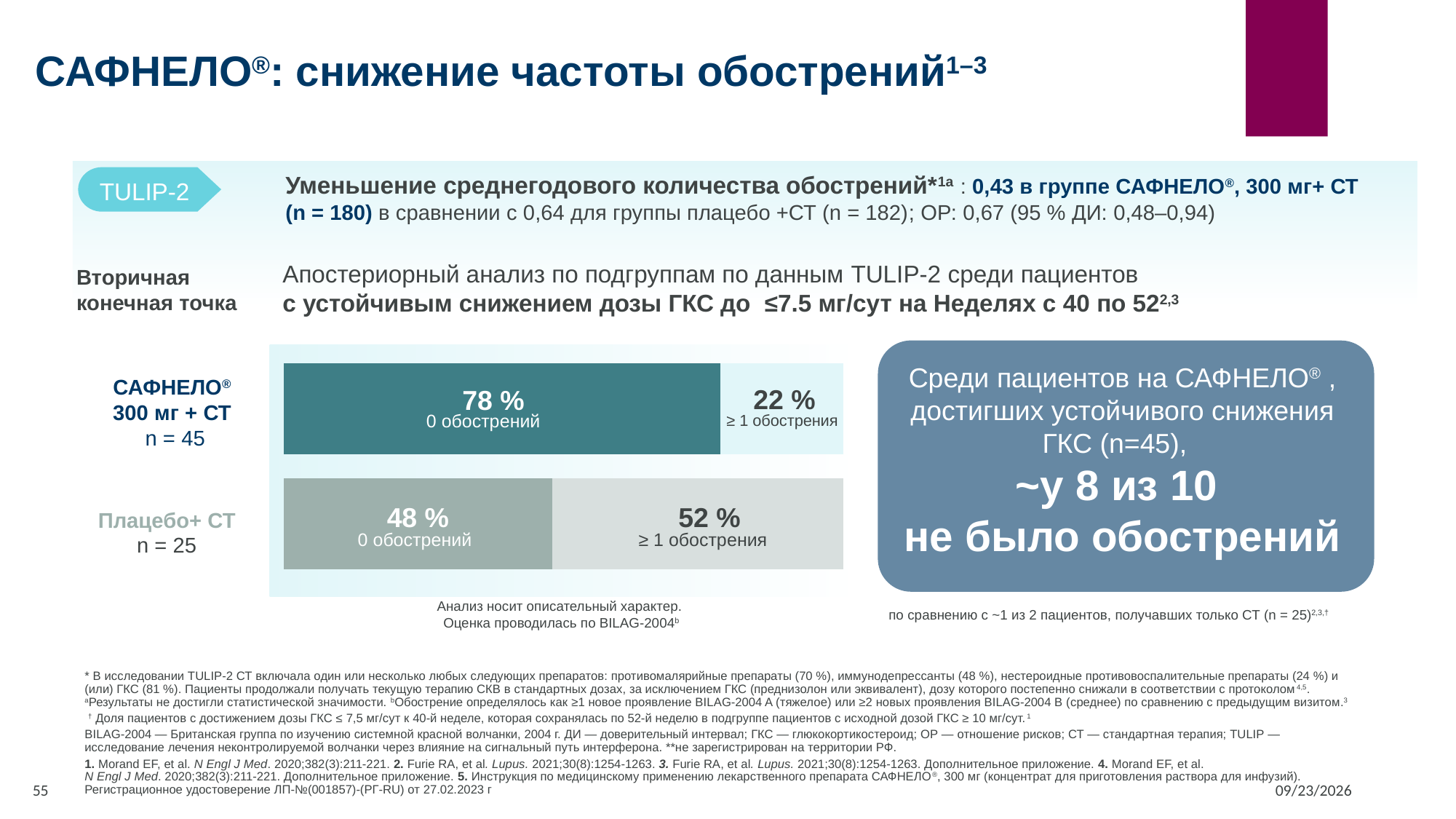
What kind of chart is shown on the slide? bar chart What percentage of patients in the САФНЕЛО 300 мг + СТ group had 0 обострений? 78 % What is the difference in the share of patients with 0 обострений between the САФНЕЛО 300 мг + СТ group and the Плацебо+ СТ group? 30 % How many patients (n) are in the Плацебо+ СТ group shown in the chart? 25 Which group has the higher share of patients with 0 обострений? САФНЕЛО 300 мг + СТ What percentage of patients in the Плацебо+ СТ group had ≥ 1 обострения? 52 % What percentage of patients in the Плацебо+ СТ group had 0 обострений? 48 % What percentage of patients in the САФНЕЛО 300 мг + СТ group had ≥ 1 обострения? 22 % How many patient groups (bars) are shown in the chart? 2 Is the share of patients with ≥ 1 обострения larger in the Плацебо+ СТ group or in the САФНЕЛО 300 мг + СТ group? Плацебо+ СТ Which group has the lower share of patients with ≥ 1 обострения? САФНЕЛО 300 мг + СТ What is the total of the two segments in the САФНЕЛО 300 мг + СТ bar? 100 %